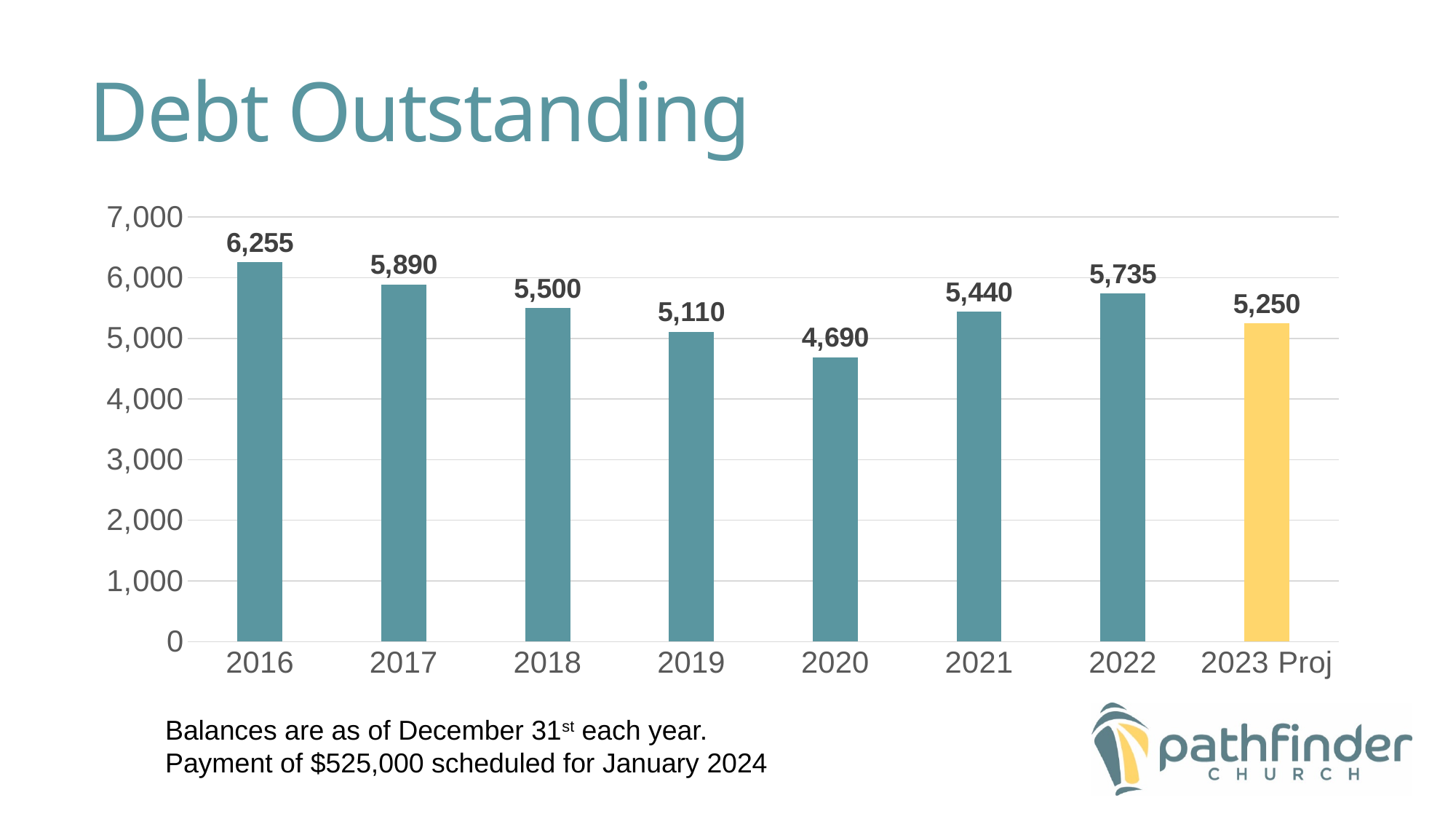
Which year has the highest debt outstanding? 2016 Which year has the lowest debt outstanding? 2020 Which bar is shown in a different colour (yellow) from the others? 2023 Proj Is the value for 2019 greater or less than 6,000? less What is the projected debt outstanding for 2023 Proj? 5,250 What is the debt outstanding value for 2016? 6,255 What is the difference between the debt outstanding in 2016 and 2017? 365 What is the difference between the debt outstanding in 2022 and 2023 Proj? 485 How many years (categories) are shown on the x axis? 8 Which is larger, the debt outstanding in 2021 or in 2022? 2022 What is the debt outstanding value for 2020? 4,690 What kind of chart is shown on the slide? bar chart